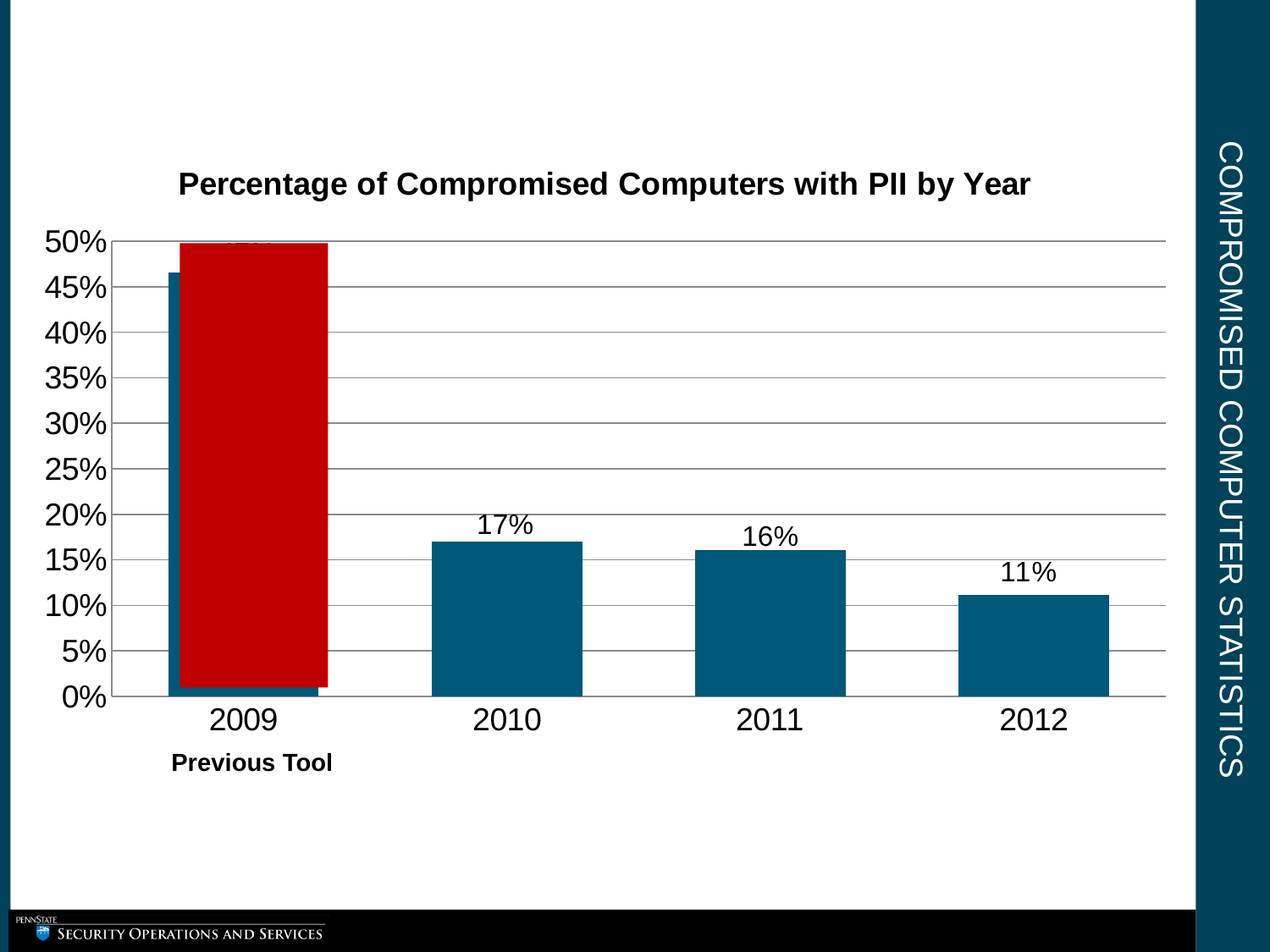
What is the value for 2012? 11% Is the value for 2009 greater or less than 40%? greater What is the value for 2011? 16% Which is larger, the value for 2010 or the value for 2011? 2010 What is the value for 2010? 17% What is the difference between the values for 2010 and 2012? 6% What kind of chart is shown on the slide? bar chart Which year has the lowest percentage of compromised computers with PII? 2012 How many years are shown on the x axis? 4 What is the difference between the values for 2011 and 2012? 5% Do the values rise or fall from 2009 to 2012? fall Which year has the highest percentage of compromised computers with PII? 2009